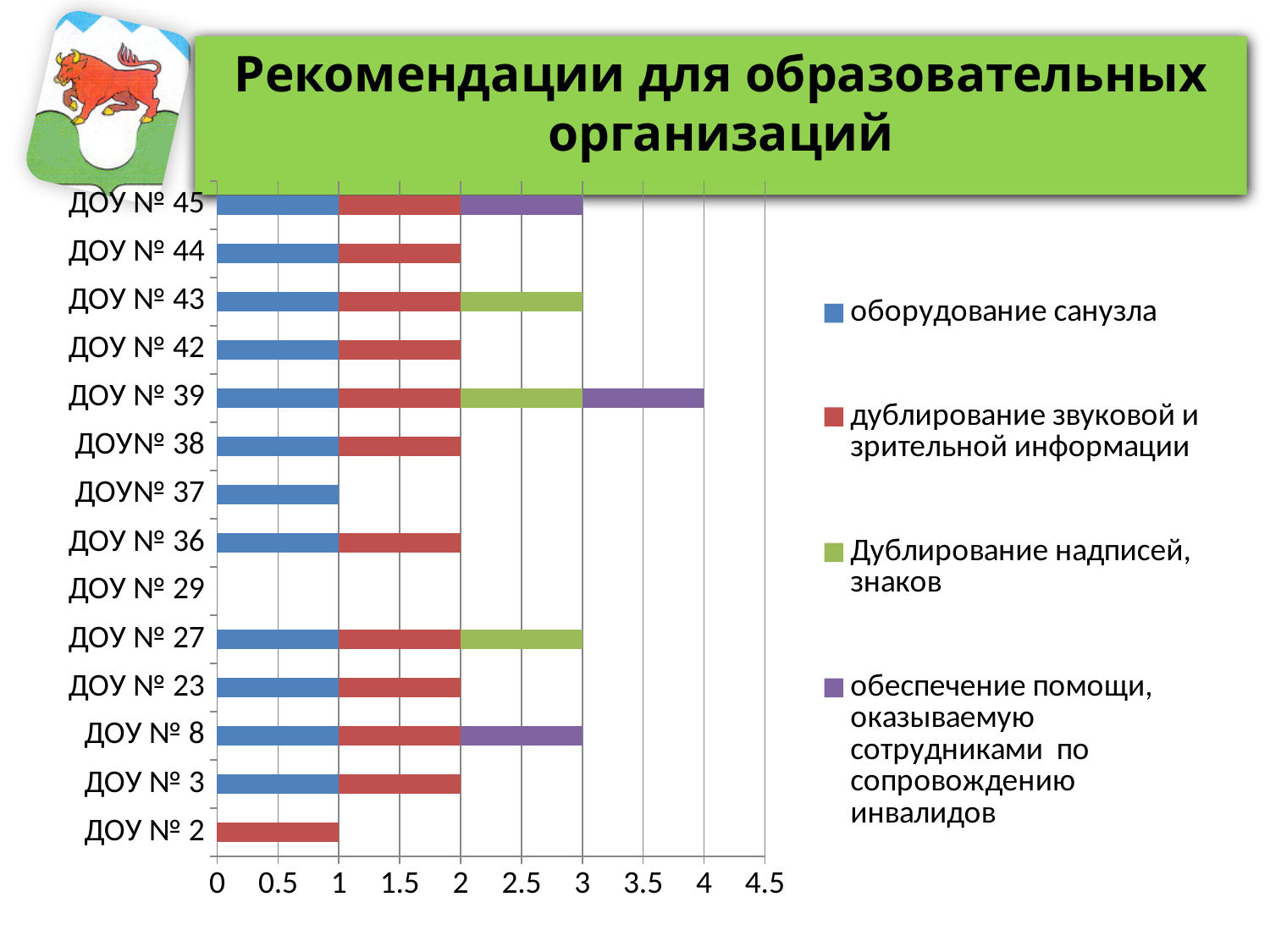
How many series does the chart legend list? 4 What is the value of the 'дублирование звуковой и зрительной информации' segment for ДОУ № 2? 1 What kind of chart is shown on the slide? Stacked bar chart Which series is shown in purple in the chart legend? обеспечение помощи, оказываемую сотрудниками по сопровождению инвалидов What is the total length of the stacked bar for ДОУ № 39? 4 What is the total length of the stacked bar for ДОУ № 45? 3 What is the title shown above the chart on the slide? Рекомендации для образовательных организаций What is the difference between the total bar length for ДОУ № 39 and for ДОУ № 37? 3 Which organisation has the longest stacked bar in the chart? ДОУ № 39 Which has the longer stacked bar, ДОУ № 39 or ДОУ № 44? ДОУ № 39 Which organisation has no bar at all in the chart? ДОУ № 29 How many organisations (categories) are listed on the vertical axis of the chart? 14